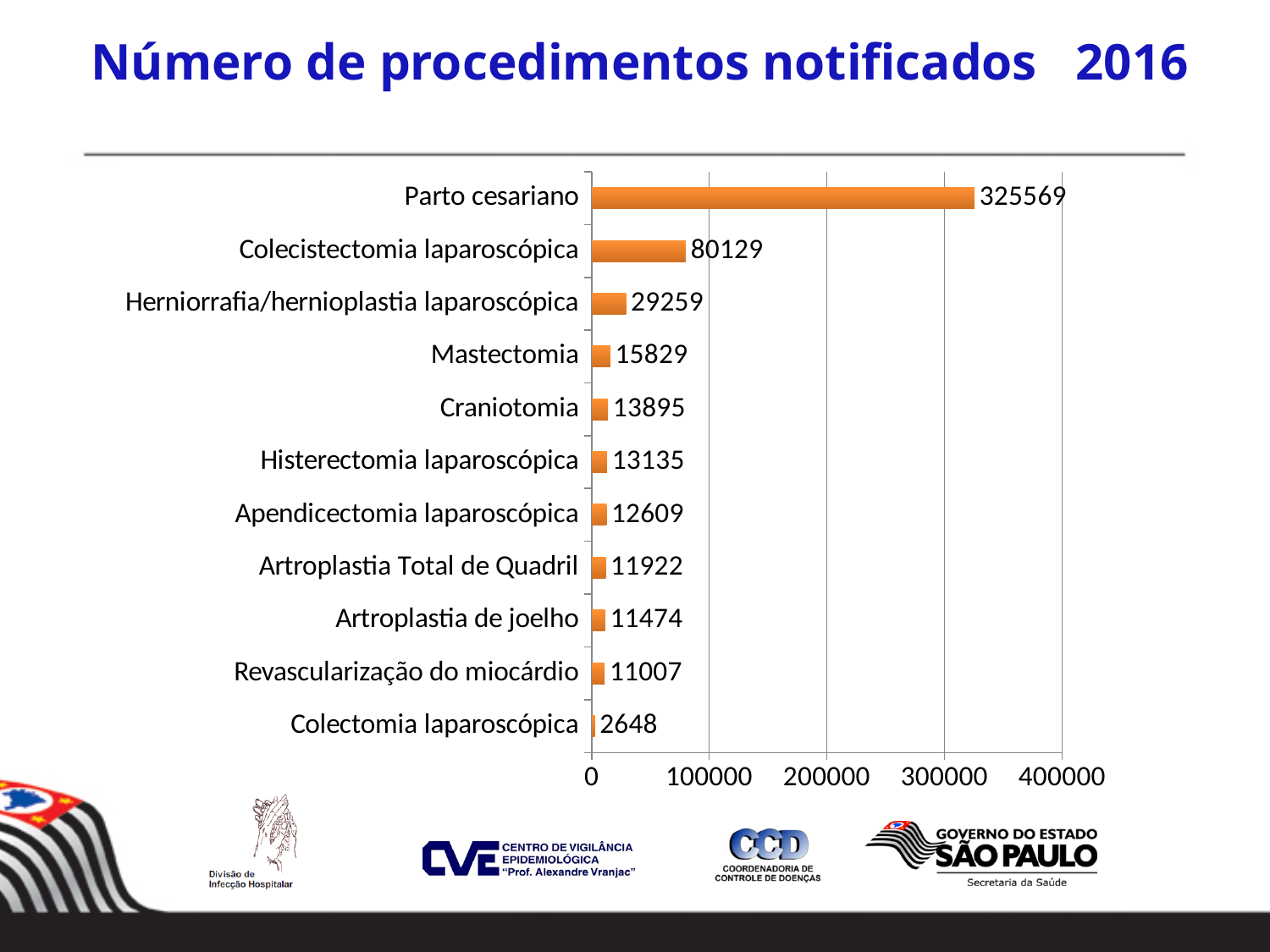
What is the difference between the values for Parto cesariano and Colecistectomia laparoscópica? 245440 What is the value shown for Revascularização do miocárdio? 11007 How many procedures are listed in the chart? 11 Which procedure has the lowest number of notified procedures? Colectomia laparoscópica What is the number of notified procedures for Parto cesariano? 325569 Is the value for Parto cesariano greater or less than 300000? greater Which procedure has the highest number of notified procedures? Parto cesariano What is the value shown for Colecistectomia laparoscópica? 80129 What is the difference between the values for Herniorrafia/hernioplastia laparoscópica and Mastectomia? 13430 What kind of chart is shown on the slide? bar chart What is the value shown for Mastectomia? 15829 Which has a larger value, Craniotomia or Apendicectomia laparoscópica? Craniotomia